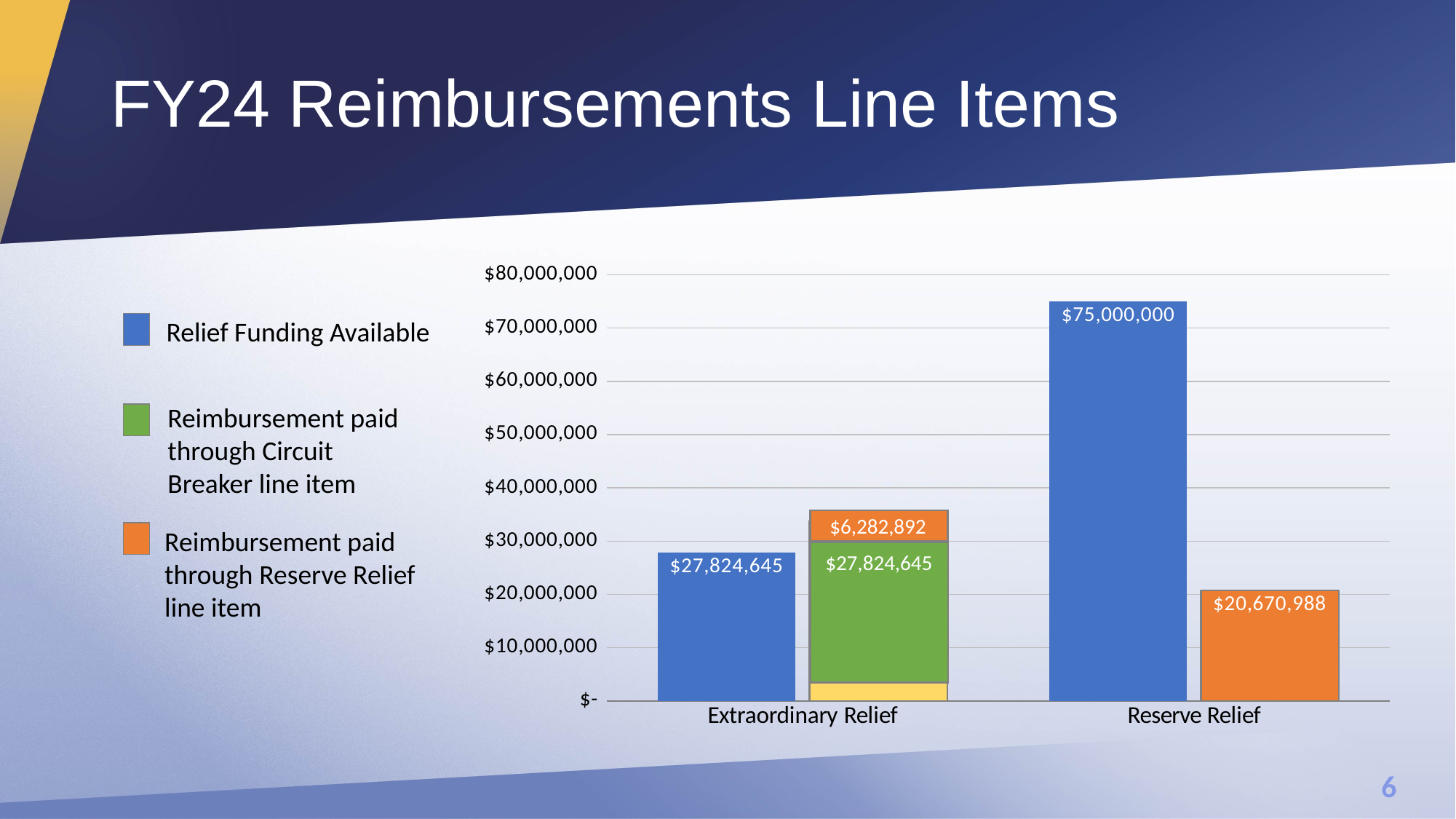
What kind of chart is shown on the slide? bar chart What is the Reimbursement paid through Circuit Breaker line item for Extraordinary Relief? $27,824,645 How many categories are shown on the x axis of the chart? 2 What is the difference between the Reimbursement paid through Reserve Relief line item for Reserve Relief and for Extraordinary Relief? $14,388,096 What is the Relief Funding Available for Reserve Relief? $75,000,000 For Reserve Relief, which is larger: Relief Funding Available or Reimbursement paid through Reserve Relief line item? Relief Funding Available What is the difference in Relief Funding Available between Reserve Relief and Extraordinary Relief? $47,175,355 Is the Relief Funding Available for Reserve Relief greater or less than $70,000,000? greater What is the Reimbursement paid through Reserve Relief line item for Extraordinary Relief? $6,282,892 What is the Relief Funding Available for Extraordinary Relief? $27,824,645 Which category has the higher Relief Funding Available? Reserve Relief What is the Reimbursement paid through Reserve Relief line item for Reserve Relief? $20,670,988